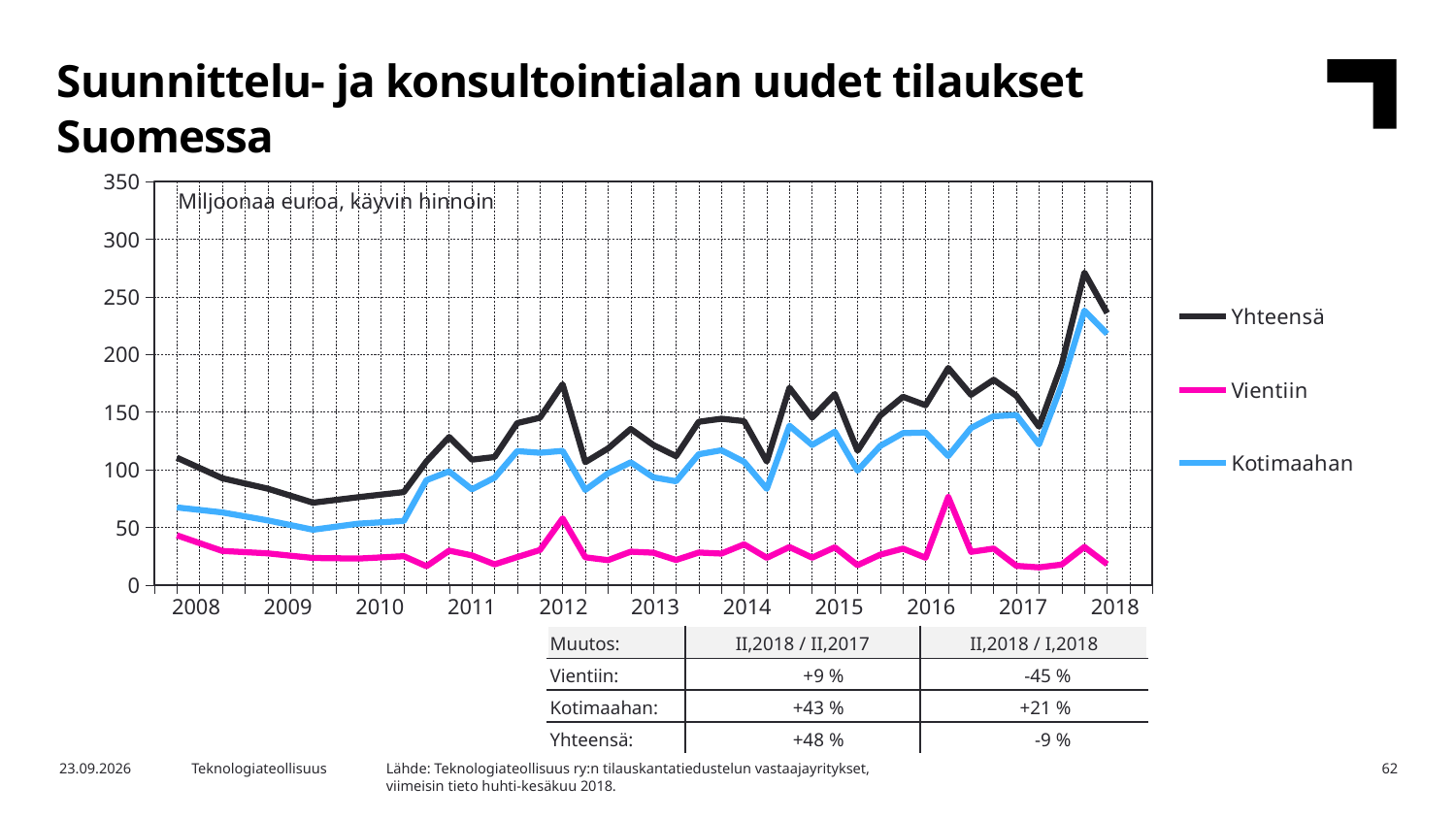
How many series does the chart legend list? 3 Is the peak value of the Vientiin line in 2016 greater or less than 50? greater Which series has the lowest values throughout the chart? Vientiin Which series are listed in the chart legend? Yhteensä, Vientiin, Kotimaahan Is the lowest value of the Yhteensä line around 2009 greater or less than 100? less What kind of chart is shown on the slide? line chart Which series has the highest values throughout the chart? Yhteensä Does the Yhteensä line rise or fall from 2008 to 2009? fall What unit label is printed inside the chart area? Miljoonaa euroa, käyvin hinnoin Which series is larger in 2018, Kotimaahan or Vientiin? Kotimaahan